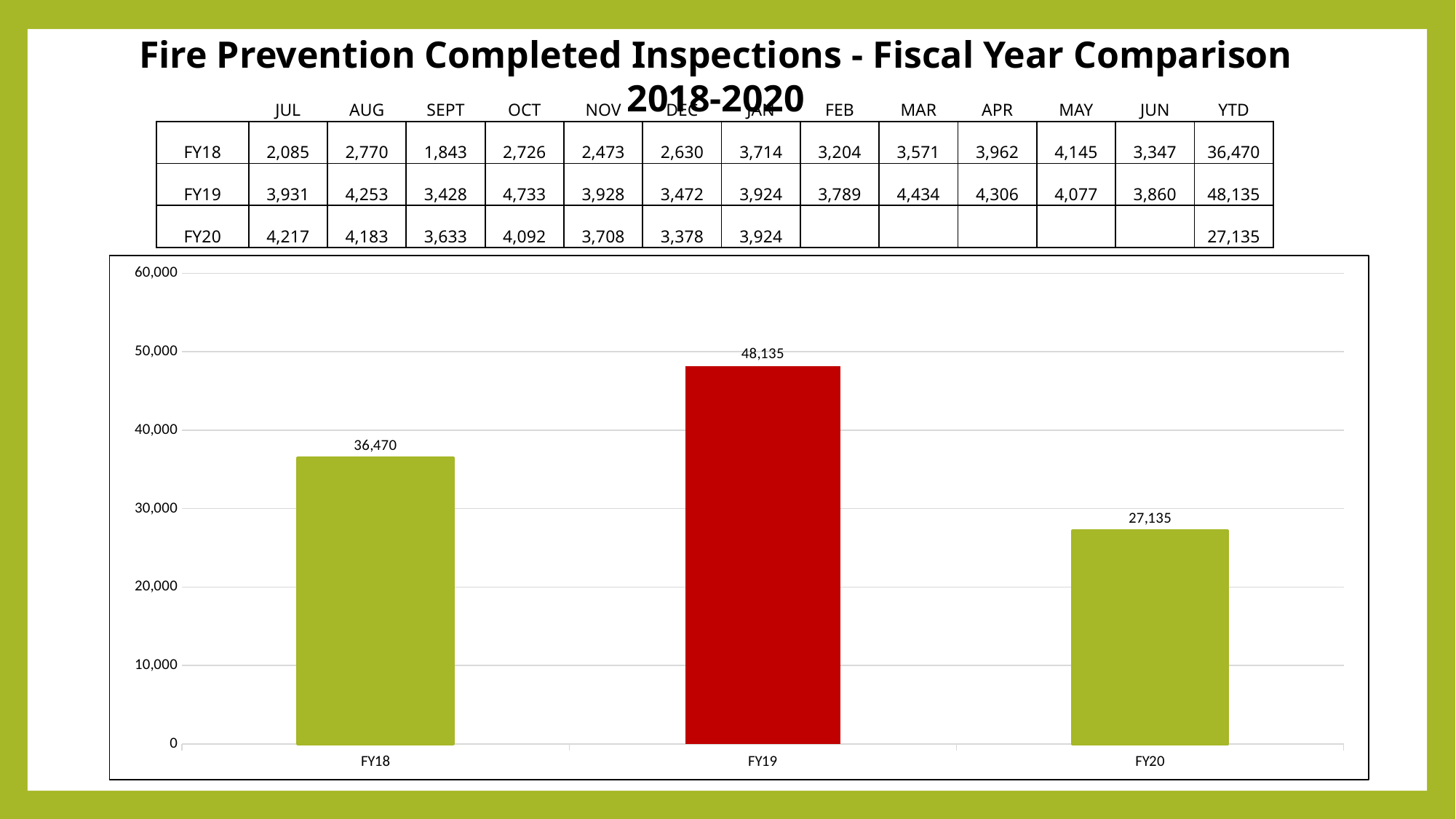
What is the difference between the FY19 and FY18 bar values? 11,665 What is the value of the bar for FY19? 48,135 What is the difference between the FY18 and FY20 bar values? 9,335 Which is larger, the bar for FY18 or the bar for FY20? FY18 Which fiscal year has the highest bar? FY19 What kind of chart is shown on the slide? Bar chart What is the value of the bar for FY20? 27,135 How many bars are shown in the chart? 3 Which bar is coloured red? FY19 Which fiscal year has the lowest bar? FY20 Is the value for FY19 greater or less than 40,000? greater What is the value of the bar for FY18? 36,470